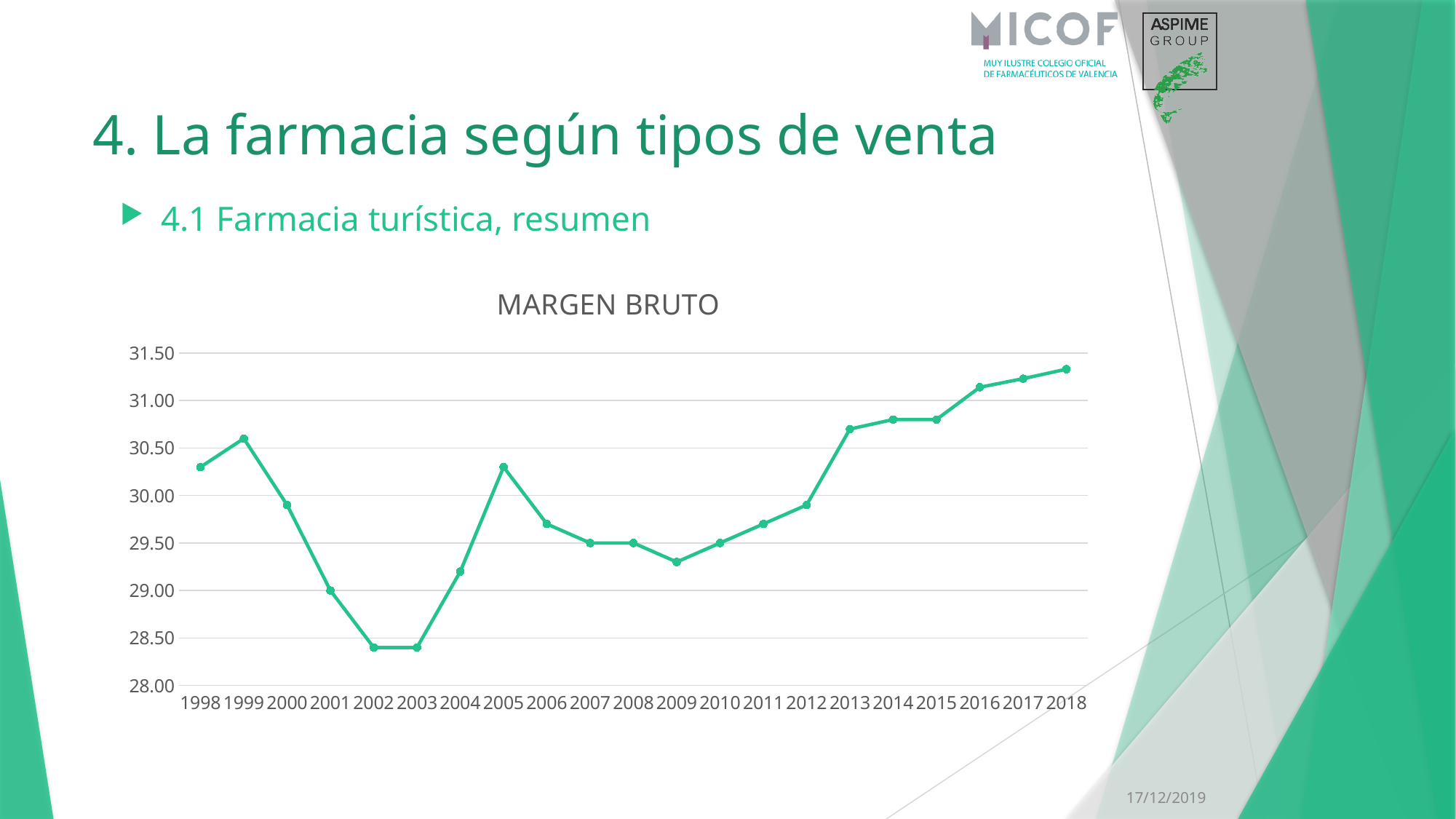
Which year has the highest value in the MARGEN BRUTO chart? 2018 What is the value for 2010 in the MARGEN BRUTO chart? 29.50 Which year has the larger value, 2012 or 2013? 2013 Is the value for 2009 greater or less than 29.50? less Is the value for 2016 greater or less than 31.00? greater How many years are plotted on the x axis of the chart? 21 Do the values rise or fall from 1999 to 2002? fall What is the value for 2001 in the MARGEN BRUTO chart? 29.00 Is the value for 2002 greater or less than 29.00? less What kind of chart is shown on the slide? line chart What is the title of the chart? MARGEN BRUTO Do the values rise or fall from 2009 to 2018? rise